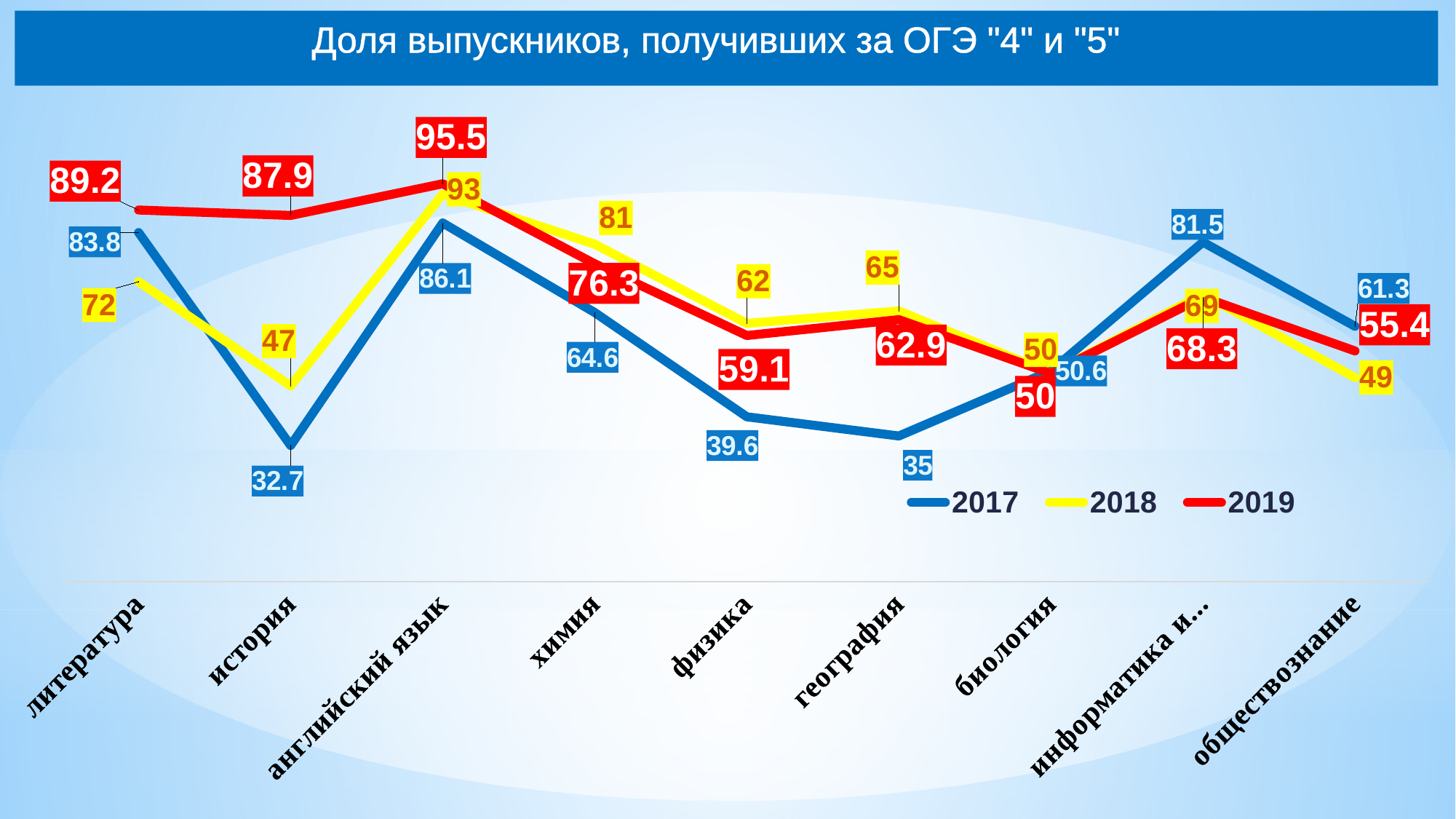
Which subject has the highest 2019 value? английский язык Which is larger for физика: the 2018 value or the 2019 value? 2018 Which subject has the lowest 2017 value? история Which colour represents the 2018 series in the legend? yellow What is the difference between the 2019 and 2017 values for история? 55.2 Which is larger for информатика: the 2017 value or the 2018 value? 2017 How many subject categories are shown on the x axis? 9 How many series does the legend list? 3 What kind of chart is shown on the slide? line chart What is the 2019 value for английский язык? 95.5 What is the 2017 value for история? 32.7 What is the 2018 value for химия? 81